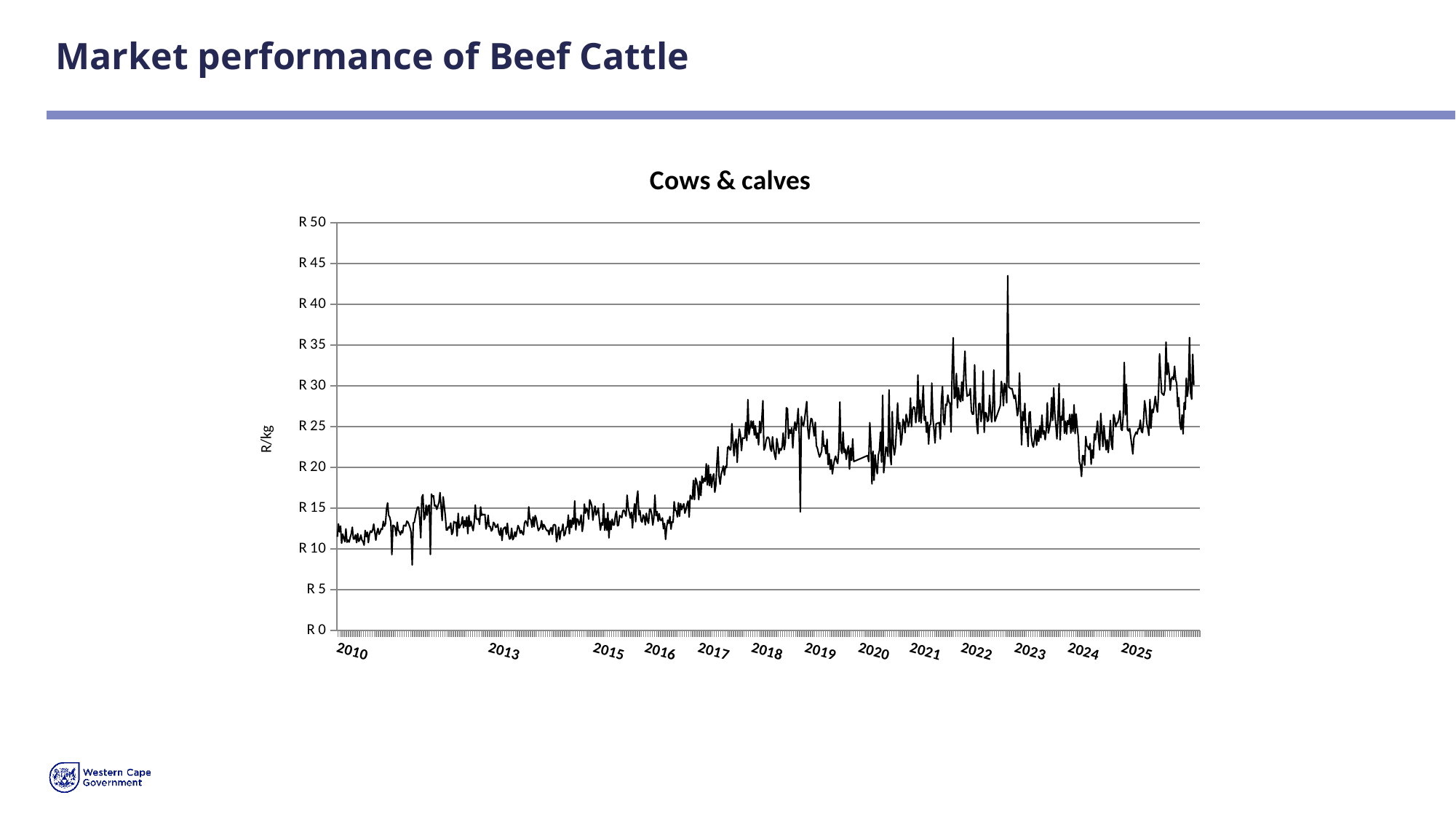
Is the value around 2017 greater or less than R 15? greater Is the value at the start of 2010 greater or less than R 15? less How many data series are plotted on the chart? 1 Is the value around 2013 greater or less than R 20? less What is the title of the chart? Cows & calves Overall, do the values rise or fall from 2010 to 2025? rise What is the label on the vertical axis of the chart? R/kg What kind of chart is shown on the slide? line chart What is the highest tick value shown on the vertical axis? R 50